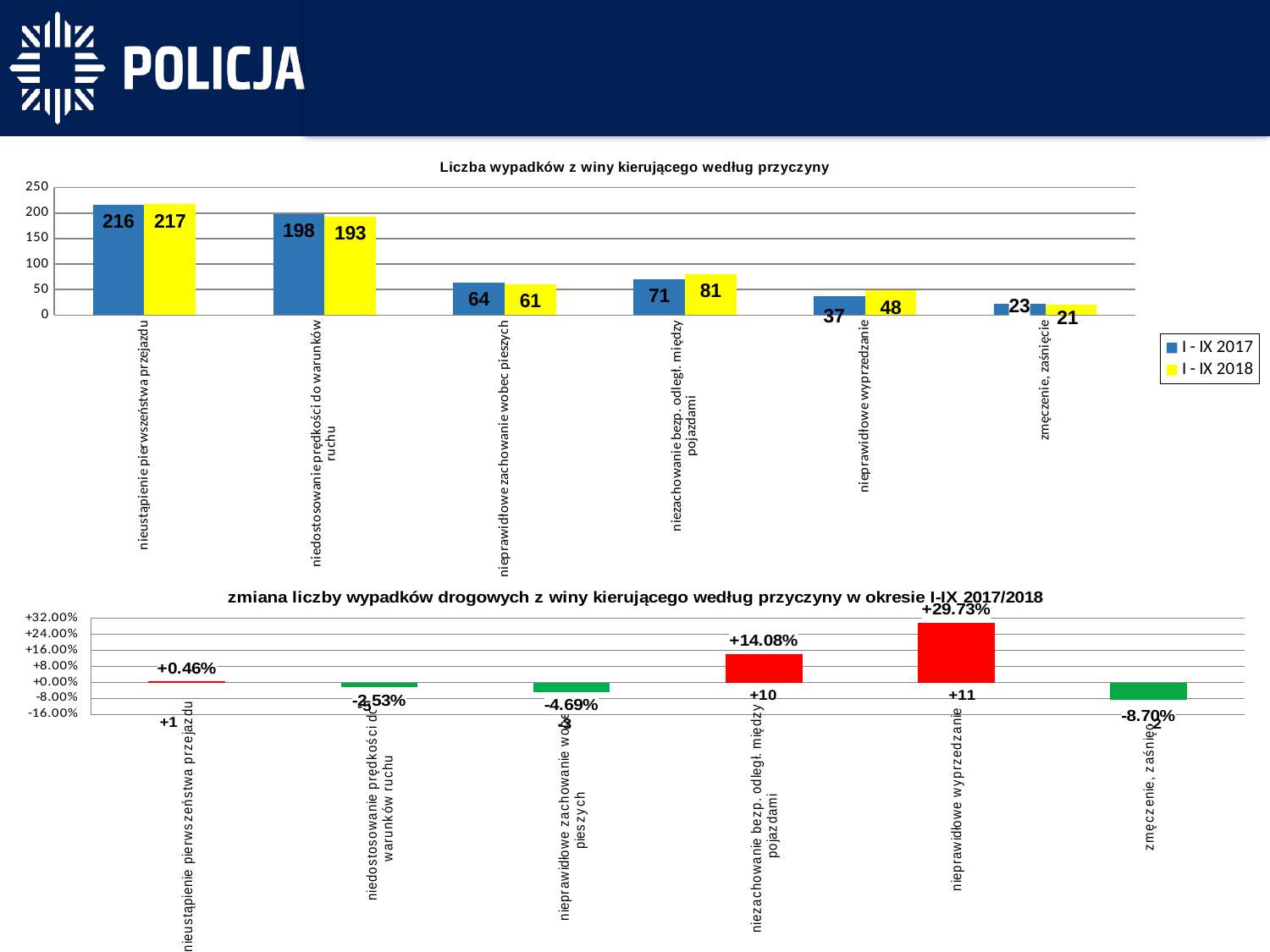
In the chart 'Liczba wypadków z winy kierującego według przyczyny', which category has the highest I - IX 2017 value? nieustąpienie pierwszeństwa przejazdu In the chart 'Liczba wypadków z winy kierującego według przyczyny', which category has the lowest I - IX 2018 value? zmęczenie, zaśnięcie In the chart 'Liczba wypadków z winy kierującego według przyczyny', which is larger for 'niedostosowanie prędkości do warunków ruchu': the I - IX 2017 value or the I - IX 2018 value? I - IX 2017 In the bottom chart 'zmiana liczby wypadków drogowych z winy kierującego według przyczyny w okresie I-IX 2017/2018', which category has the lowest percentage change? zmęczenie, zaśnięcie How many categories are shown in the chart 'Liczba wypadków z winy kierującego według przyczyny'? 6 In the bottom chart 'zmiana liczby wypadków drogowych z winy kierującego według przyczyny w okresie I-IX 2017/2018', what is the percentage change for 'nieprawidłowe wyprzedzanie'? +29.73% In the chart 'Liczba wypadków z winy kierującego według przyczyny', what is the I - IX 2017 value for 'nieprawidłowe wyprzedzanie'? 37 What type of chart is the top chart 'Liczba wypadków z winy kierującego według przyczyny'? bar chart In the chart 'Liczba wypadków z winy kierującego według przyczyny', what is the value for 'nieustąpienie pierwszeństwa przejazdu' in the I - IX 2018 series? 217 How many series does the legend of the chart 'Liczba wypadków z winy kierującego według przyczyny' list? 2 In the chart 'Liczba wypadków z winy kierującego według przyczyny', what is the difference between the I - IX 2018 and I - IX 2017 values for 'niezachowanie bezp. odległ. między pojazdami'? 10 In the bottom chart 'zmiana liczby wypadków drogowych z winy kierującego według przyczyny w okresie I-IX 2017/2018', what is the percentage change for 'niezachowanie bezp. odległ. między pojazdami'? +14.08%